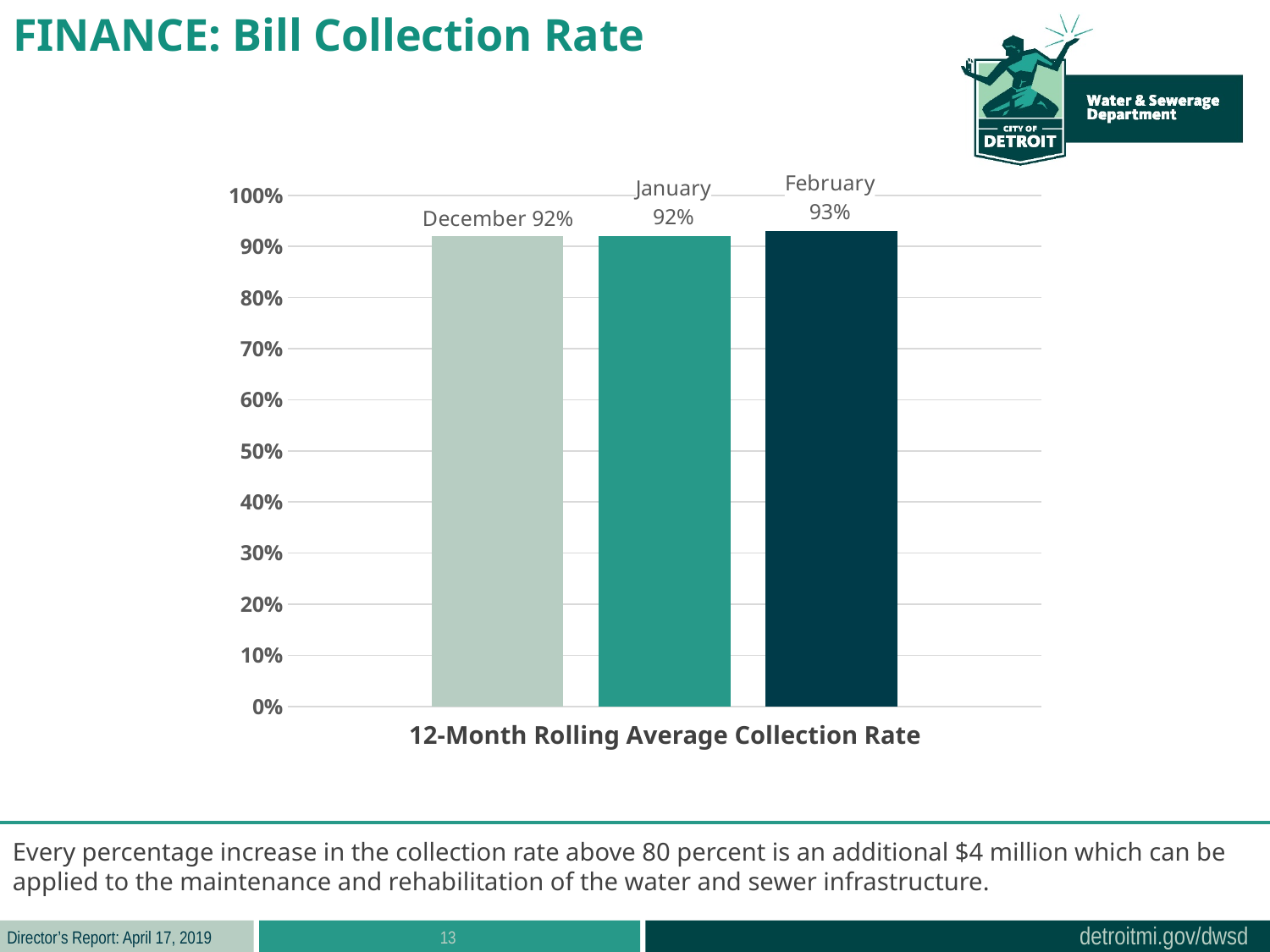
How many months are plotted on the chart? 3 Which is larger, the collection rate for January or for February? February Which month has the highest collection rate shown on the chart? February What is the difference between the February and December collection rates? 1% Is the collection rate for December greater or less than 80%? greater Do the collection rates rise or fall from December to February? Rise What is the title shown beneath the chart's bars? 12-Month Rolling Average Collection Rate What kind of chart is shown on the slide? Bar chart What is the 12-month rolling average collection rate for January? 92% What is the 12-month rolling average collection rate for December? 92% Is the collection rate for February greater or less than 100%? less What is the 12-month rolling average collection rate for February? 93%